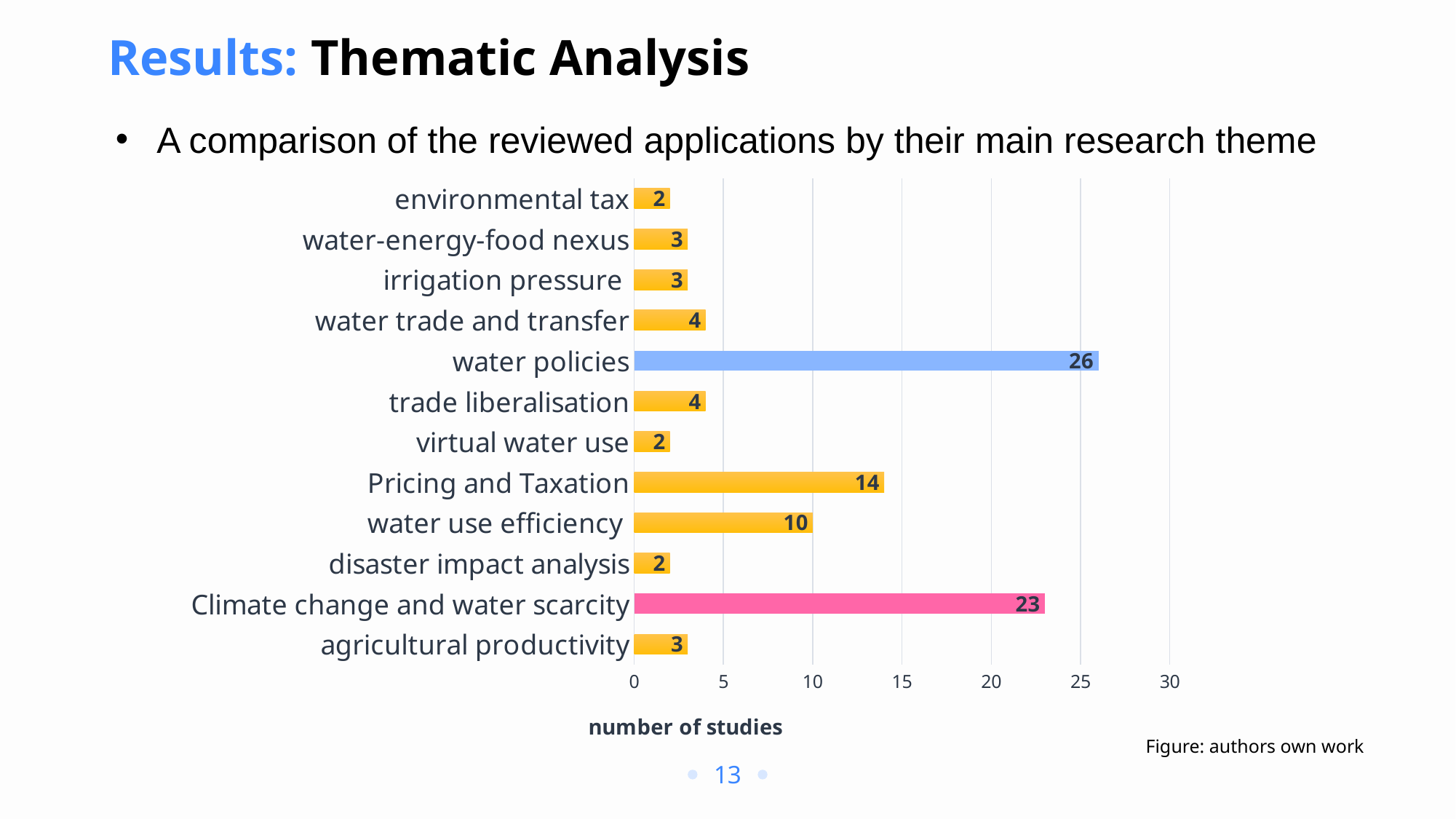
What is the number of studies for water use efficiency? 10 What is the difference in number of studies between Pricing and Taxation and water use efficiency? 4 What kind of chart is shown on the slide? bar chart What is the number of studies for Pricing and Taxation? 14 How many studies are shown for water policies? 26 What is the number of studies for Climate change and water scarcity? 23 Which has more studies, water trade and transfer or irrigation pressure? water trade and transfer What is the difference in number of studies between water policies and Climate change and water scarcity? 3 Which research theme has the highest number of studies? water policies Is the value for Climate change and water scarcity greater or less than 20? greater How many research themes are shown in the chart? 12 What is the label of the horizontal axis of the chart? number of studies